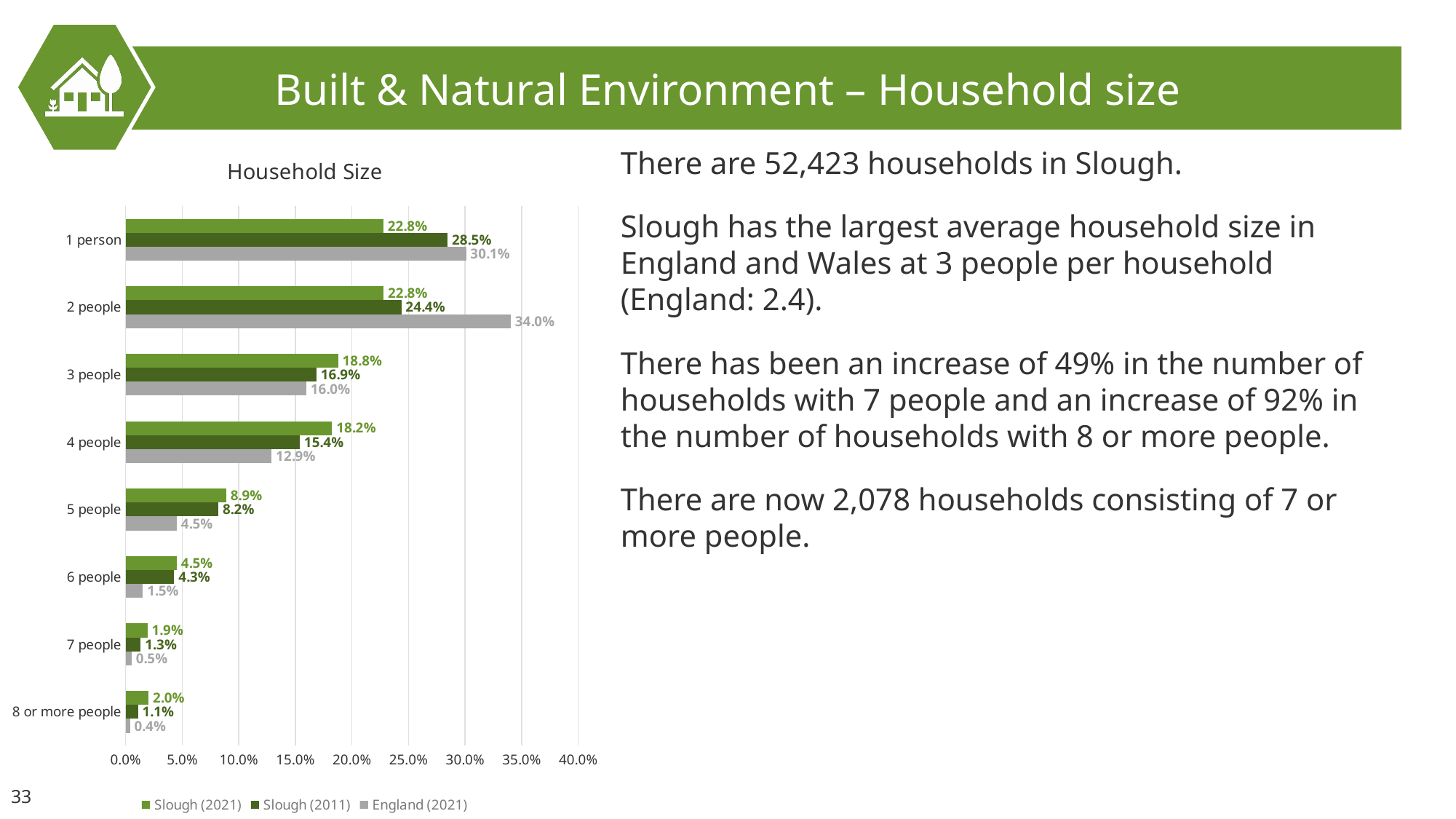
How many series does the legend list? 3 How many household size categories are shown on the chart? 8 For 5 people households, which is larger: Slough (2021) or England (2021)? Slough (2021) What is the title of the chart? Household Size What is the Slough (2011) value for 1 person households? 28.5% Which household size category has the lowest Slough (2011) value? 8 or more people Is the Slough (2011) value for 2 people households greater or less than 20.0%? greater What is the Slough (2021) value for 3 people households? 18.8% What is the difference between the England (2021) and Slough (2021) values for 4 people households? 5.3% What is the England (2021) value for 2 people households? 34.0% Which household size category has the highest England (2021) value? 2 people What kind of chart is shown on the slide? Bar chart